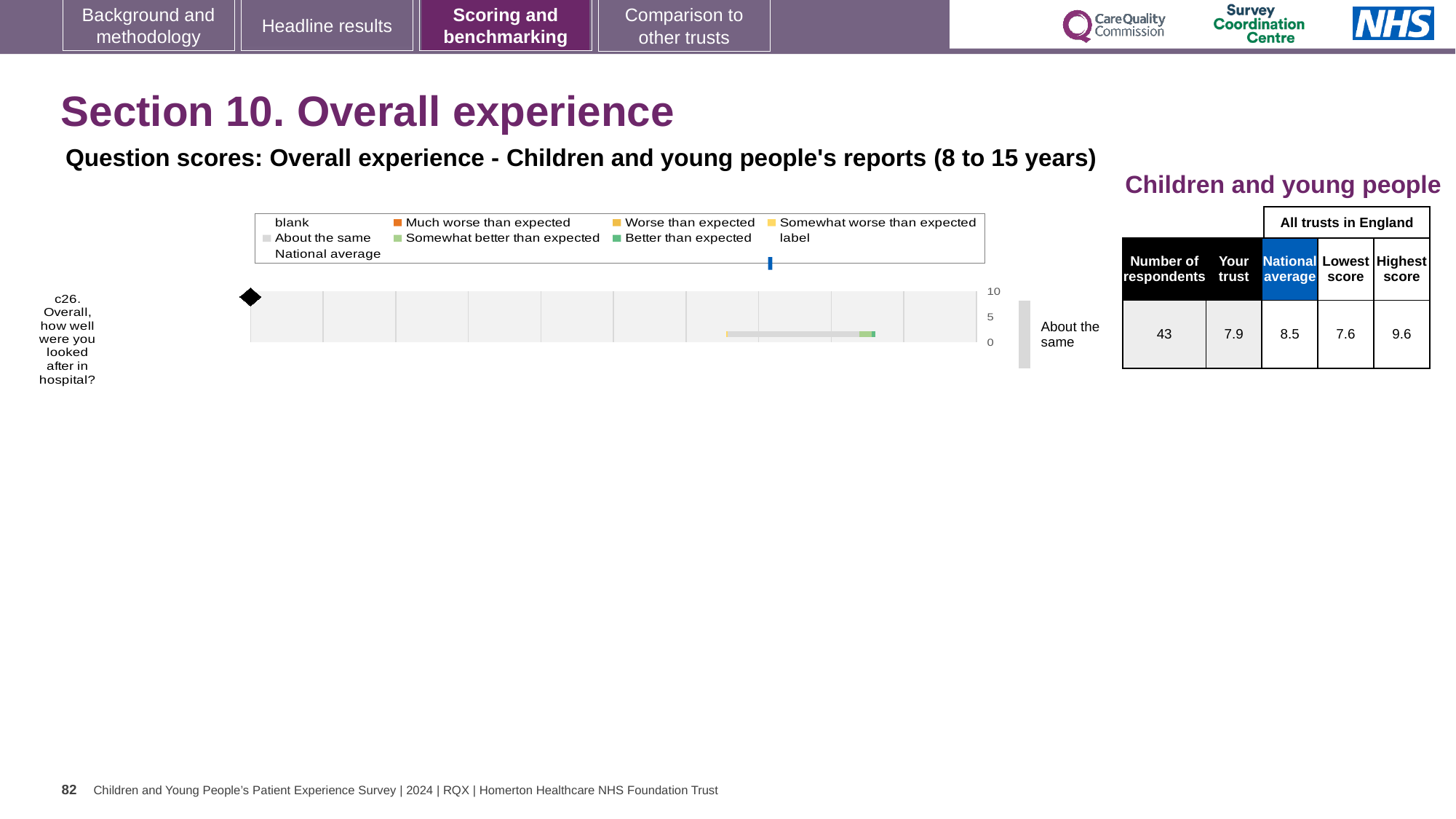
What is the 'Your trust' score for question c26 'Overall, how well were you looked after in hospital?'? 7.9 What is the difference between the highest score and the lowest score for question c26? 2.0 What benchmark category is shown next to the bar for question c26? About the same What kind of chart is shown on the slide? Bar chart Is the 'Your trust' score for question c26 greater or less than 5? greater How many respondents answered question c26? 43 What is the national average score for question c26? 8.5 How many questions are plotted in the chart? 1 Which is larger for question c26: the 'Your trust' score or the national average? National average What is the highest score among all trusts in England for question c26? 9.6 By how much does the national average exceed the 'Your trust' score for question c26? 0.6 What is the lowest score among all trusts in England for question c26? 7.6